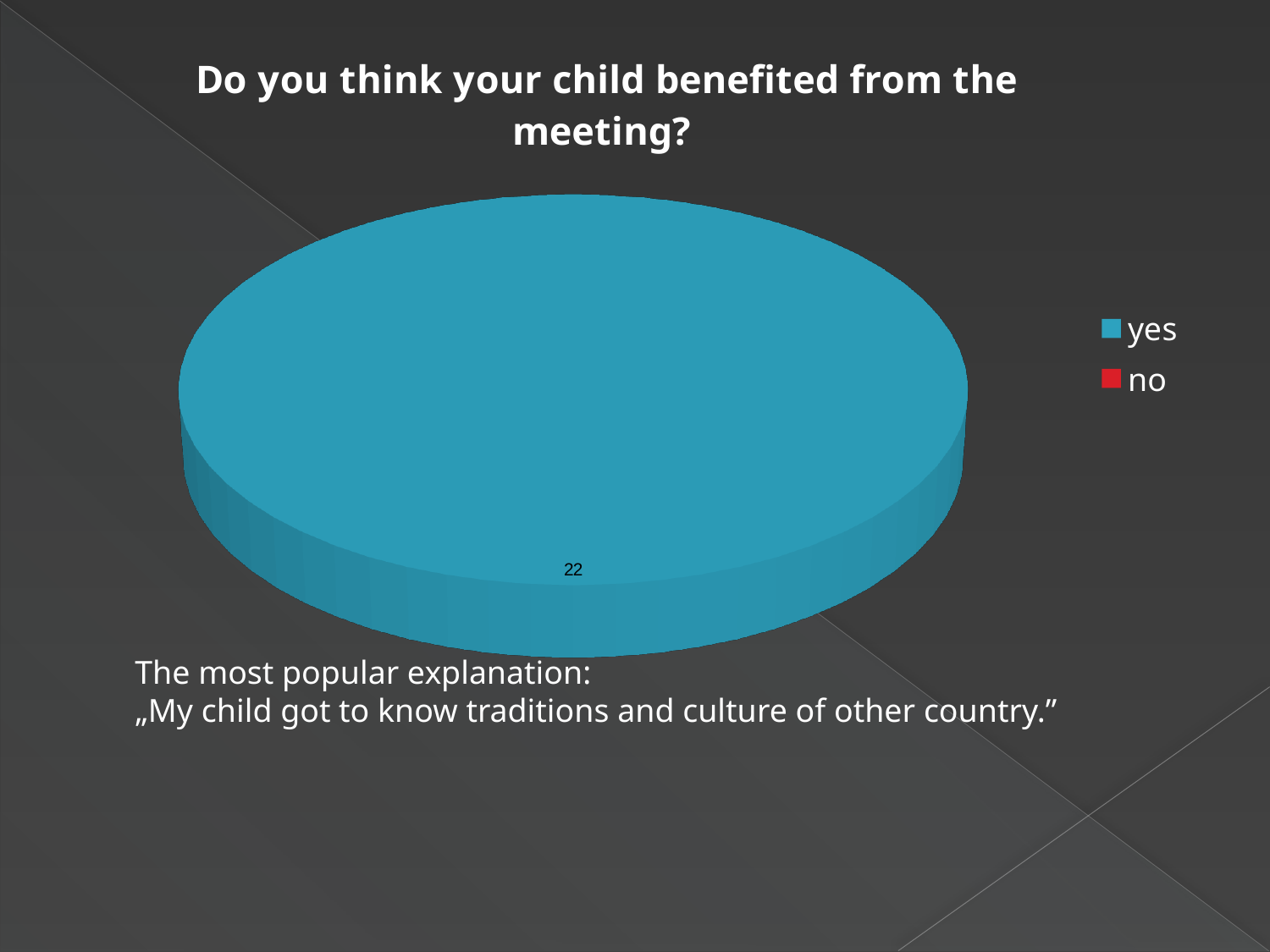
Which category has the smallest share of the pie? no Which is larger, the 'yes' slice or the 'no' slice? yes What is the title of the chart? Do you think your child benefited from the meeting? Is the value for 'yes' greater or less than 20? greater Which category has the largest slice of the pie? yes How many entries does the legend list? 2 What colour represents 'yes' in the legend? blue What value is shown for the 'yes' slice? 22 What kind of chart is shown on the slide? pie chart